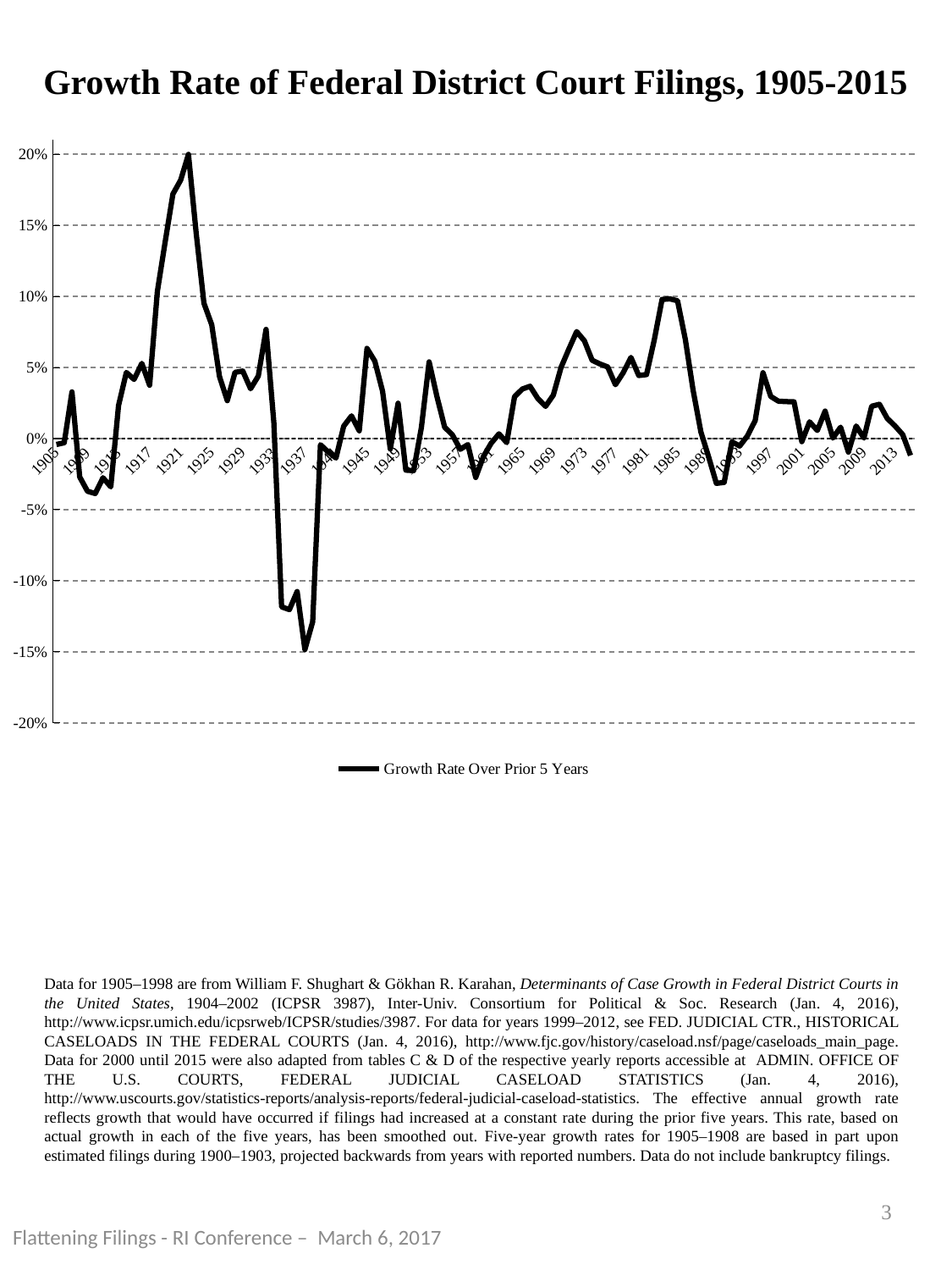
What is the legend entry for the plotted line? Growth Rate Over Prior 5 Years What kind of chart is shown on the slide? line chart In which labelled year does the growth rate reach its lowest value? 1937 Is the growth rate for 1937 greater or less than -10%? less How many series does the legend list? 1 What is the title of the chart? Growth Rate of Federal District Court Filings, 1905-2015 In which labelled year does the growth rate reach its highest value? 1921 Does the growth rate rise or fall between 1985 and 1993? fall Is the growth rate for 1909 greater or less than 0%? less Is the growth rate for 1985 greater or less than 5%? greater Does the growth rate rise or fall between 1917 and 1921? rise